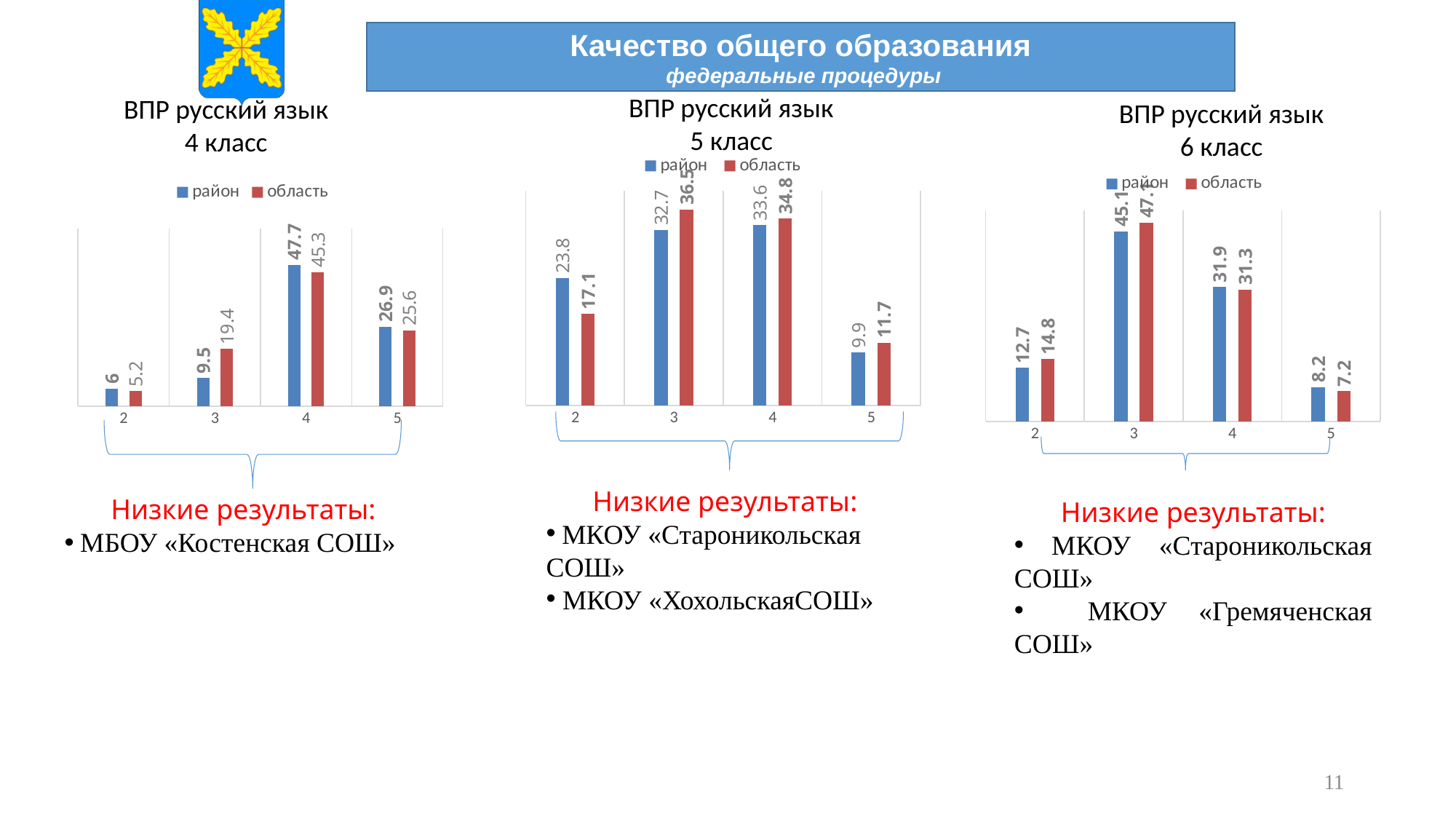
How many series does the legend of the chart 'ВПР русский язык 5 класс' list? 2 In the chart 'ВПР русский язык 6 класс', what is the difference between район and область at category 2? 2.1 In the chart 'ВПР русский язык 4 класс', what is the value for область at category 3? 19.4 In the chart 'ВПР русский язык 6 класс', which is larger at category 5: район or область? район In the chart 'ВПР русский язык 5 класс', which category has the lowest value for район? 5 In the chart 'ВПР русский язык 5 класс', which is larger at category 3: район or область? область In the chart 'ВПР русский язык 6 класс', what is the value for район at category 3? 45.1 In the chart 'ВПР русский язык 5 класс', what is the value for область at category 2? 17.1 In the chart 'ВПР русский язык 4 класс', what is the value for район at category 4? 47.7 In the chart 'ВПР русский язык 4 класс', which category has the highest value for район? 4 What type of chart is 'ВПР русский язык 6 класс'? bar chart In the chart 'ВПР русский язык 4 класс', what is the difference between район and область at category 3? 9.9